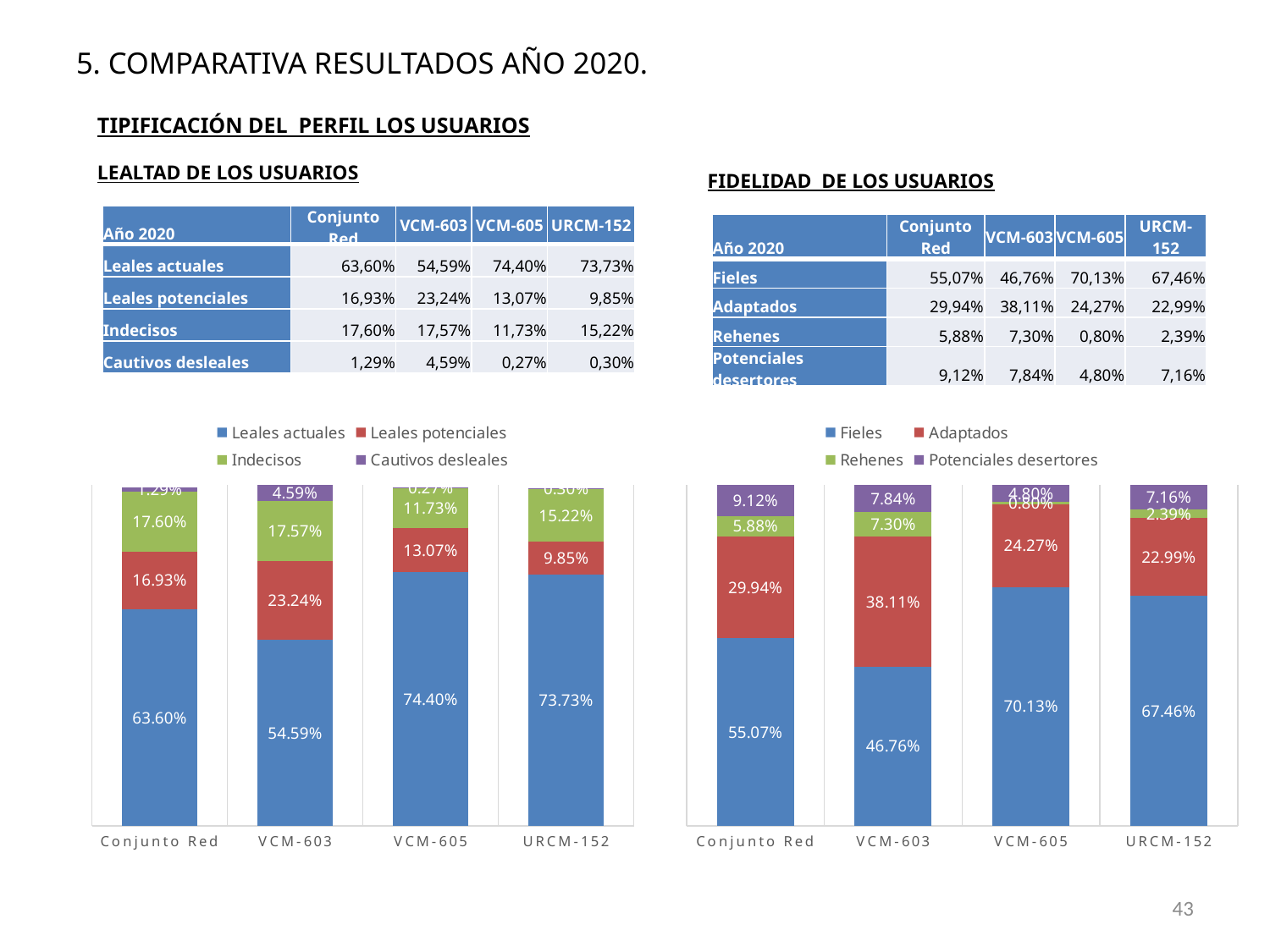
In the left chart (Lealtad de los usuarios), what is the value of Leales actuales for VCM-605? 74.40% In the left chart (Lealtad de los usuarios), what is the value of Indecisos for URCM-152? 15.22% In the left chart (Lealtad de los usuarios), which category has the highest Leales actuales value? VCM-605 How many categories are shown on the x axis of the left chart (Lealtad de los usuarios)? 4 In the right chart (Fidelidad de los usuarios), what is the value of Potenciales desertores for Conjunto Red? 9.12% In the left chart (Lealtad de los usuarios), what is the difference between the Leales potenciales values for VCM-603 and VCM-605? 10.17% What kind of chart is the left chart (Lealtad de los usuarios)? Stacked bar chart In the right chart (Fidelidad de los usuarios), what is the value of Adaptados for VCM-603? 38.11% How many series does the legend of the right chart (Fidelidad de los usuarios) list? 4 In the right chart (Fidelidad de los usuarios), which is larger: Adaptados for Conjunto Red or Adaptados for URCM-152? Conjunto Red In the right chart (Fidelidad de los usuarios), which category has the lowest Fieles value? VCM-603 Which series is shown in blue in the right chart (Fidelidad de los usuarios)? Fieles